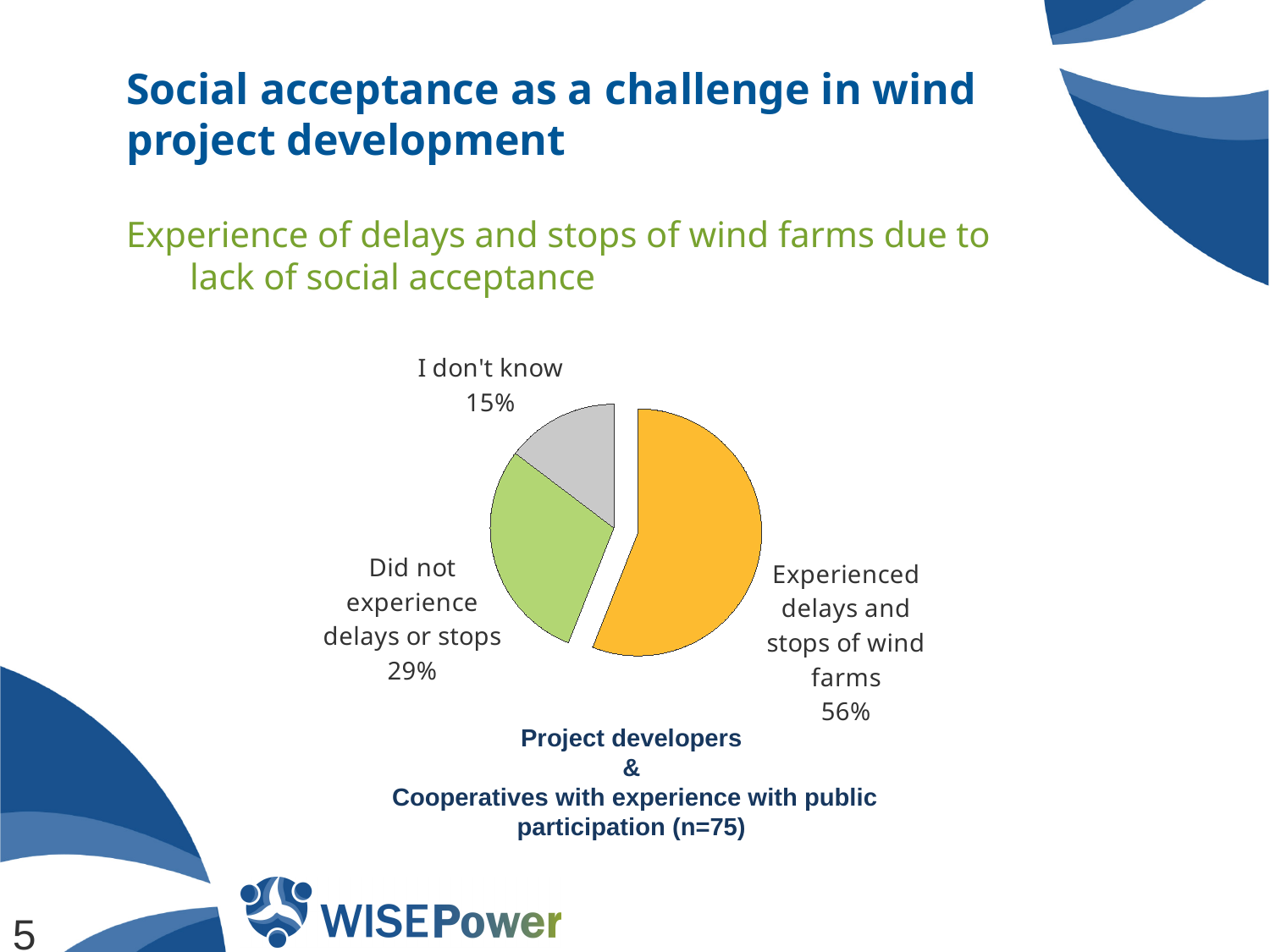
What is the difference in percentage points between 'Experienced delays and stops of wind farms' and 'Did not experience delays or stops'? 27 percentage points What kind of chart is shown on the slide? pie chart What colour is the slice for 'Experienced delays and stops of wind farms'? orange What share of respondents answered 'I don't know'? 15% How many slices does the pie chart have? 3 What is the difference in percentage points between 'Did not experience delays or stops' and 'I don't know'? 14 percentage points Which is larger: the share for 'Did not experience delays or stops' or the share for 'I don't know'? Did not experience delays or stops Which category has the largest slice of the pie? Experienced delays and stops of wind farms What share of respondents did not experience delays or stops? 29% What is the sample size (n) stated below the pie chart? n=75 What share of respondents experienced delays and stops of wind farms? 56% Which category has the smallest slice of the pie? I don't know